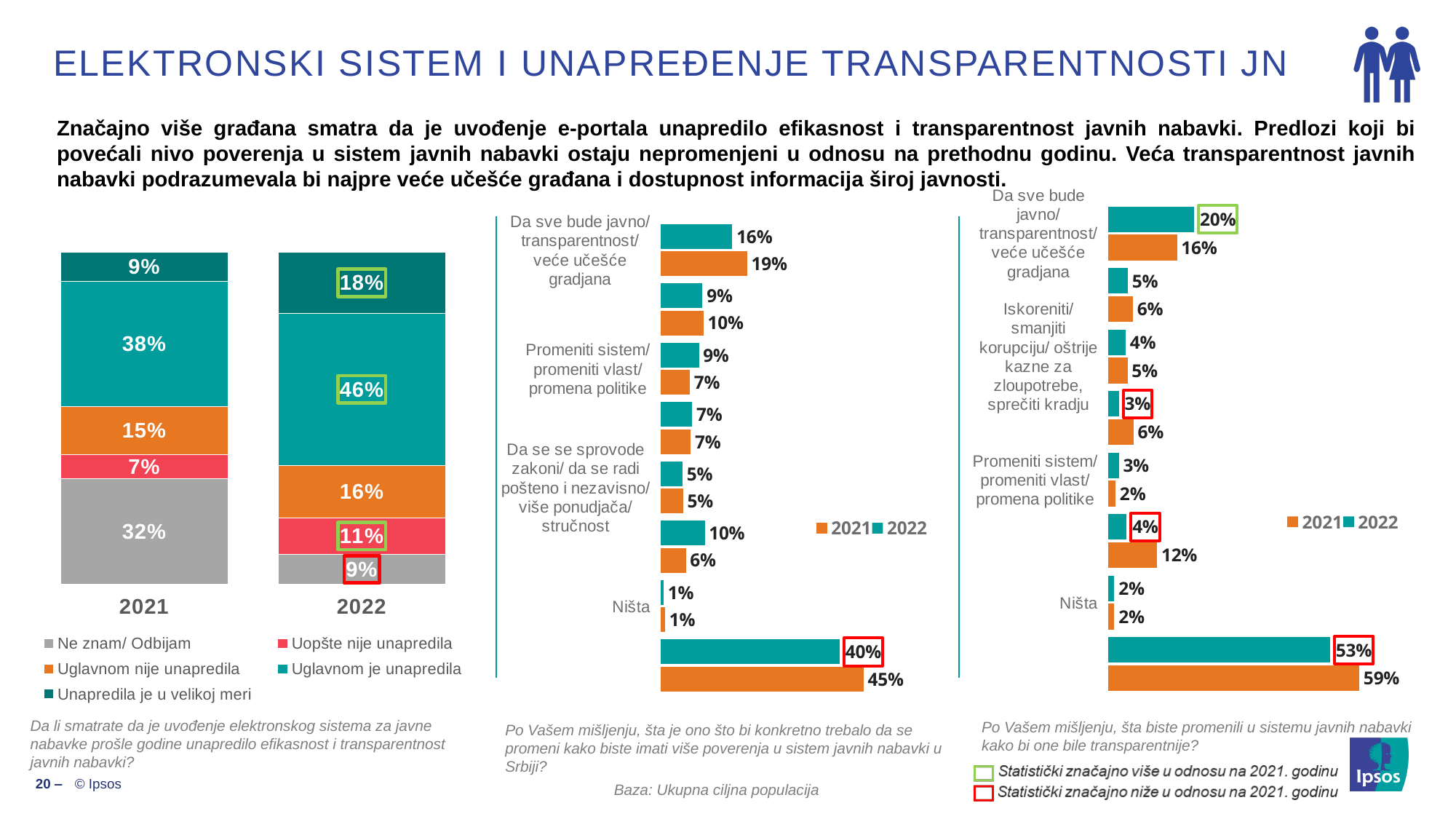
In the middle bar chart, what is the 2022 value for 'Promeniti sistem/ promeniti vlast/ promena politike'? 9% In the right bar chart, is the 2021 or the 2022 value larger for 'Promeniti sistem/ promeniti vlast/ promena politike'? 2022 In the left stacked bar chart, how many series does the legend list? 5 In the middle bar chart, what is the 2021 value for 'Da sve bude javno/ transparentnost/ veće učešće gradjana'? 19% In the right bar chart, what is the 2022 value for 'Da sve bude javno/ transparentnost/ veće učešće gradjana'? 20% In the middle bar chart, what is the 2022 value for 'Ništa'? 1% In the left stacked bar chart, by how many percentage points did 'Uopšte nije unapredila' change from 2021 to 2022? 4 percentage points In the left stacked bar chart, what is the value for 'Unapredila je u velikoj meri' in 2021? 9% In the left stacked bar chart, what is the value for 'Ne znam/ Odbijam' in 2021? 32% What type of chart is the middle chart? Bar chart In the left stacked bar chart, which segment is the largest in the 2021 bar? Uglavnom je unapredila In the left stacked bar chart, what is the value for 'Uglavnom je unapredila' in 2022? 46%